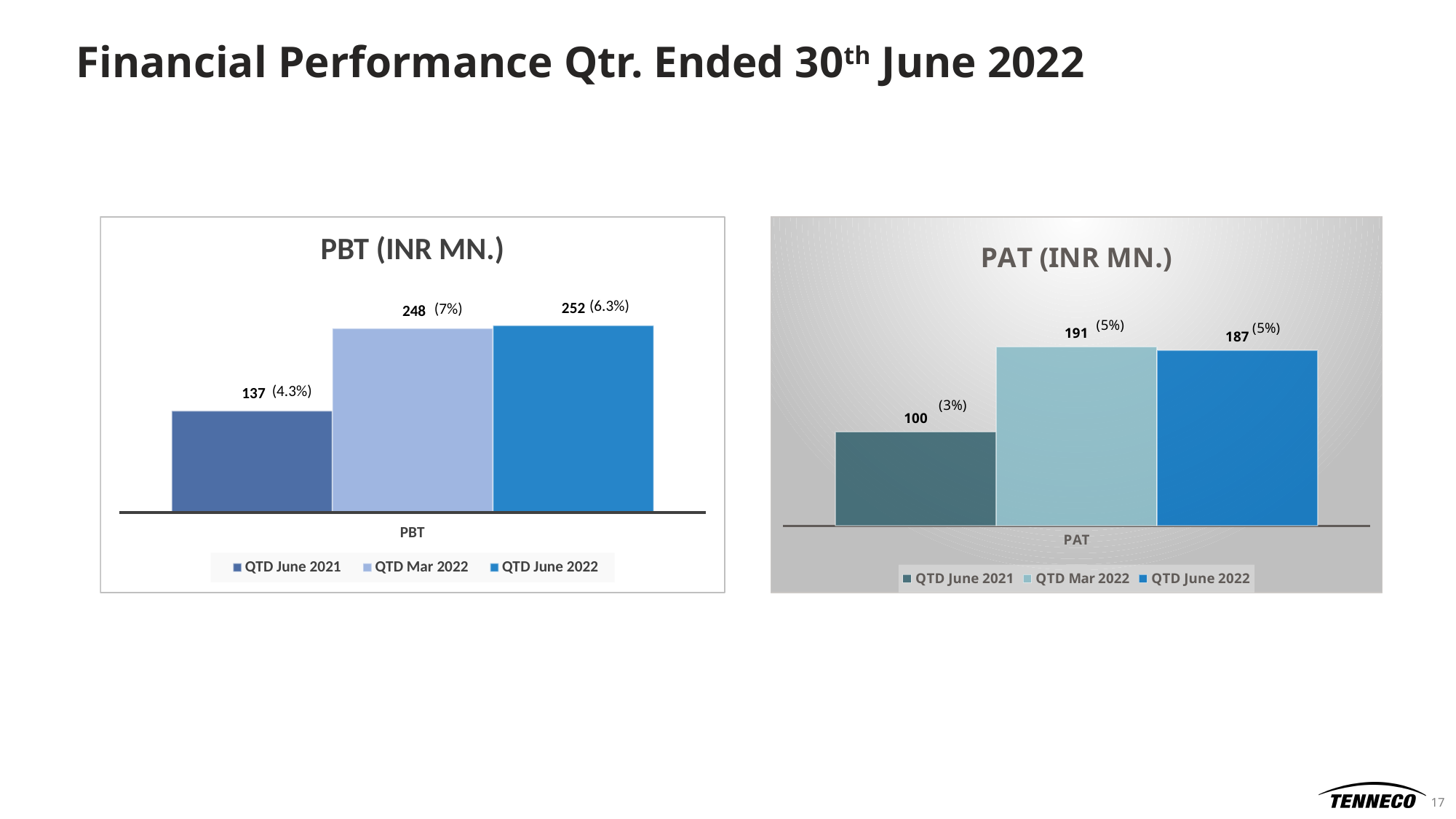
In the PBT (INR MN.) chart, what is the difference between the QTD June 2022 and QTD June 2021 values? 115 In the PAT (INR MN.) chart, what is the value for QTD Mar 2022? 191 In the PBT (INR MN.) chart, what is the value for QTD June 2022? 252 In the PBT (INR MN.) chart, which series has the lowest value? QTD June 2021 How many series does the legend of the PBT (INR MN.) chart list? 3 In the PAT (INR MN.) chart, what is the value for QTD June 2021? 100 In the PAT (INR MN.) chart, which is larger: QTD June 2021 or QTD June 2022? QTD June 2022 In the PBT (INR MN.) chart, what is the value for QTD June 2021? 137 In the PAT (INR MN.) chart, what is the difference between the QTD Mar 2022 and QTD June 2022 values? 4 What kind of chart is the PAT (INR MN.) chart? Bar chart In the PBT (INR MN.) chart, what percentage is shown next to the QTD Mar 2022 value? (7%) In the PAT (INR MN.) chart, which series has the highest value? QTD Mar 2022